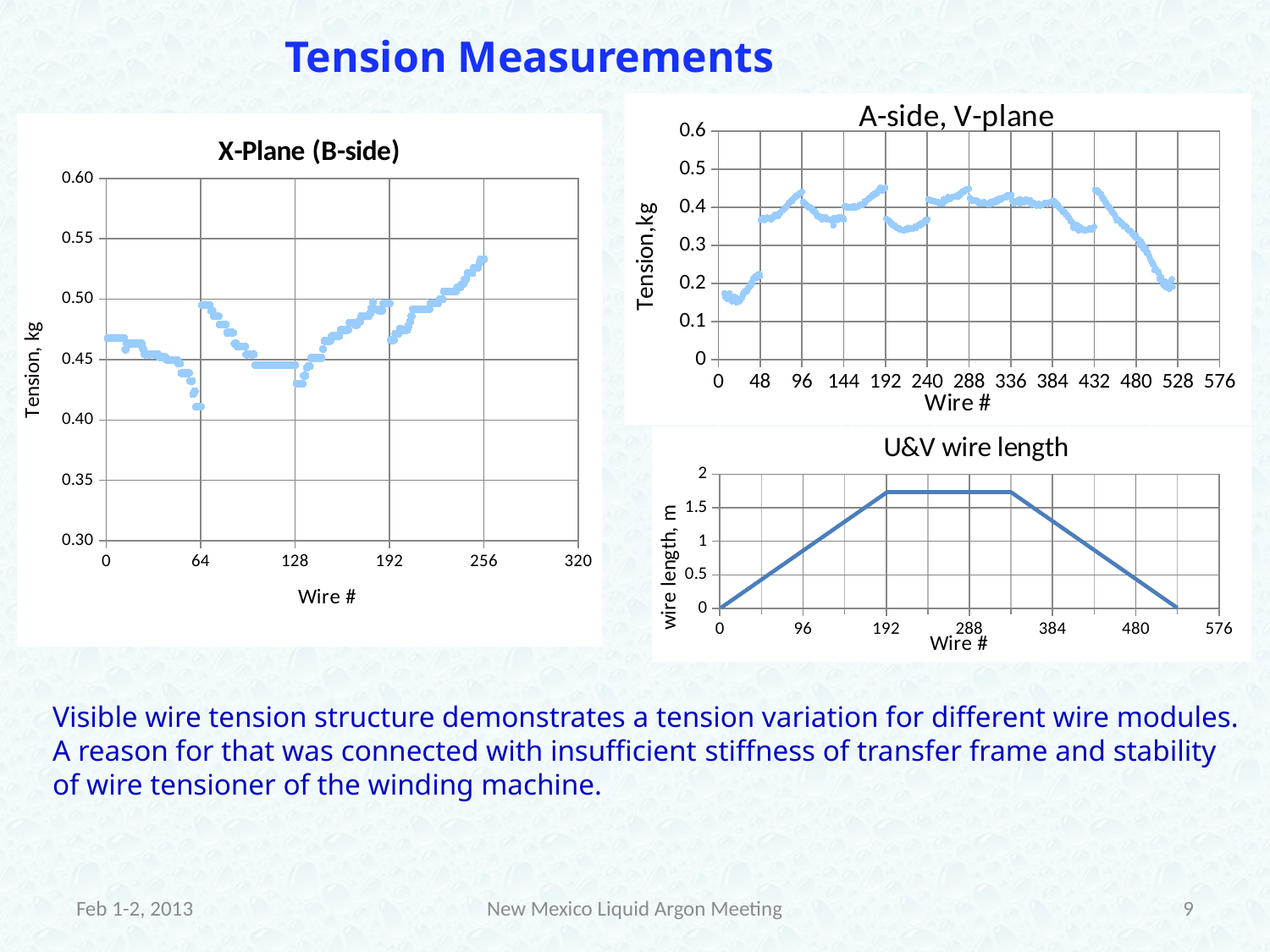
In the A-side, V-plane chart, is the tension at wire 96 greater or less than 0.4? greater In the U&V wire length chart, is the wire length at wire 288 greater or less than 1.5? greater How many charts are shown on the slide? 3 What kind of chart is the U&V wire length chart? line chart What kind of chart is the X-Plane (B-side) chart? scatter chart In the X-Plane (B-side) chart, what is the label of the y axis? Tension, kg In the U&V wire length chart, how does the wire length change from wire 336 to wire 528? it falls In the X-Plane (B-side) chart, is the lowest tension near wire 64 greater or less than 0.45? less In the U&V wire length chart, what is the label of the y axis? wire length, m